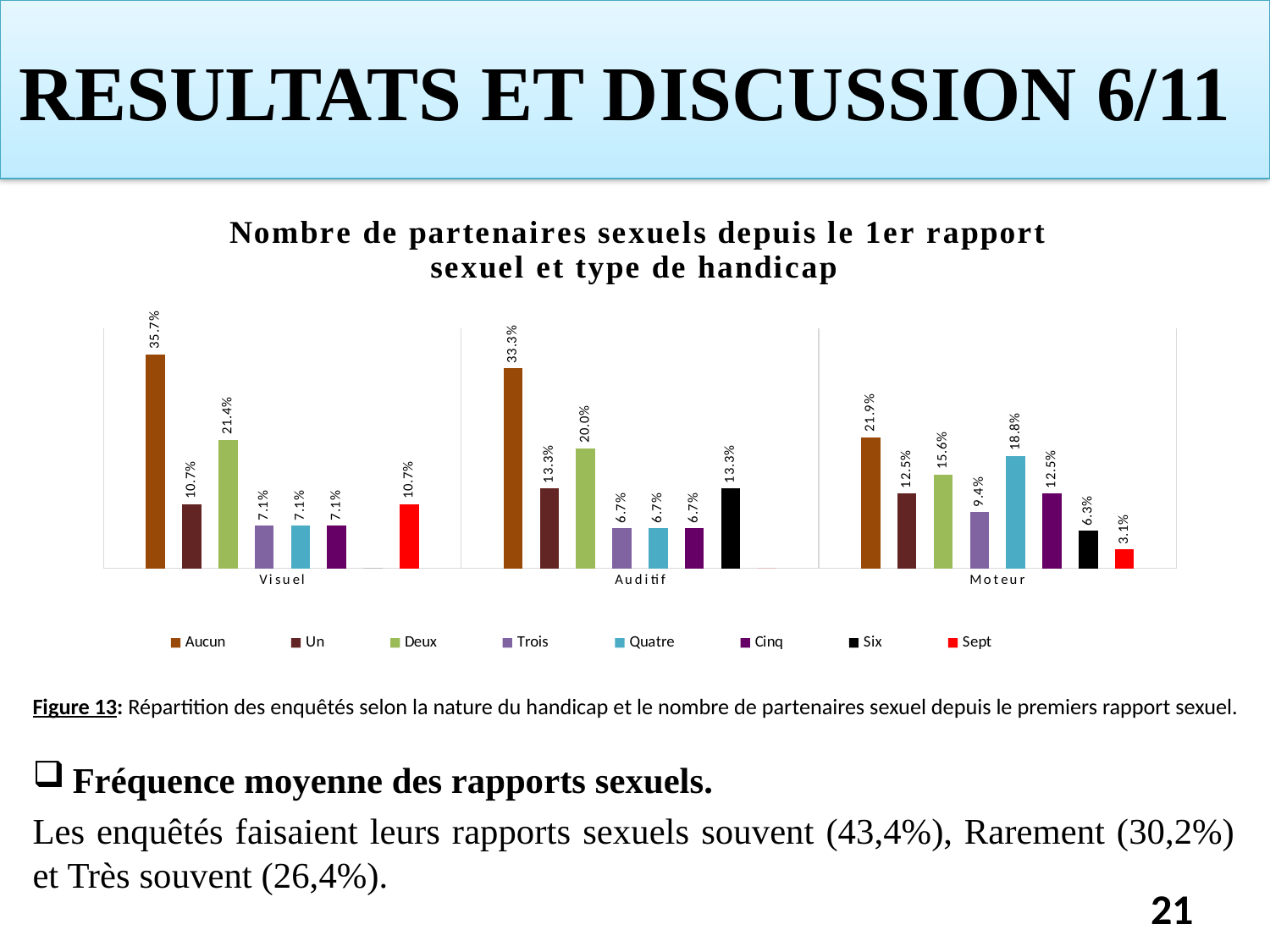
Which is larger in the Auditif group: 'Aucun' or 'Deux'? Aucun Which series has the lowest value in the Moteur group? Sept What is the value for 'Quatre' in the Moteur group? 18.8% What is the value for 'Six' in the Auditif group? 13.3% How many series does the legend list? 8 How many handicap categories are shown on the x axis? 3 Which series has the highest value in the Moteur group? Aucun What is the value for 'Aucun' in the Visuel group? 35.7% What is the title of the chart? Nombre de partenaires sexuels depuis le 1er rapport sexuel et type de handicap What is the value for 'Sept' in the Visuel group? 10.7% What is the difference between 'Aucun' and 'Deux' in the Visuel group? 14.3% What type of chart is shown on the slide? bar chart